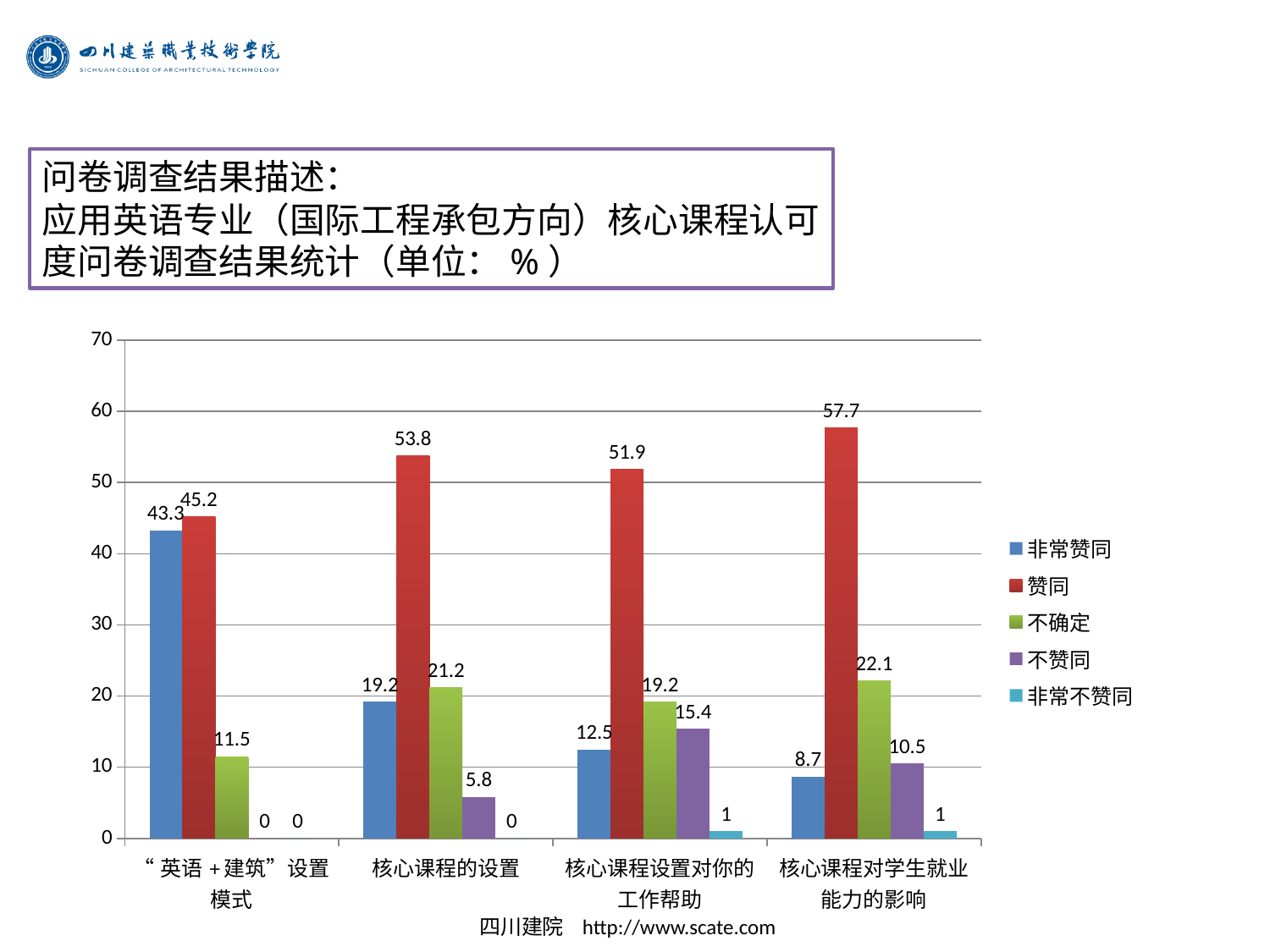
Which legend entry is shown in red? 赞同 Is the 赞同 value for 核心课程设置对你的工作帮助 greater or less than 50? greater How many categories are shown on the x axis? 4 How many series does the legend list? 5 What kind of chart is shown on the slide? bar chart Which category has the lowest 非常赞同 value? 核心课程对学生就业能力的影响 What is the difference between the 赞同 and 非常赞同 values for 核心课程的设置? 34.6 What is the value of 非常赞同 for “英语+建筑”设置模式? 43.3 Which category has the highest 赞同 value? 核心课程对学生就业能力的影响 What is the value of 不赞同 for 核心课程设置对你的工作帮助? 15.4 Which is larger for 核心课程的设置: 不确定 or 非常赞同? 不确定 What is the value of 赞同 for 核心课程对学生就业能力的影响? 57.7